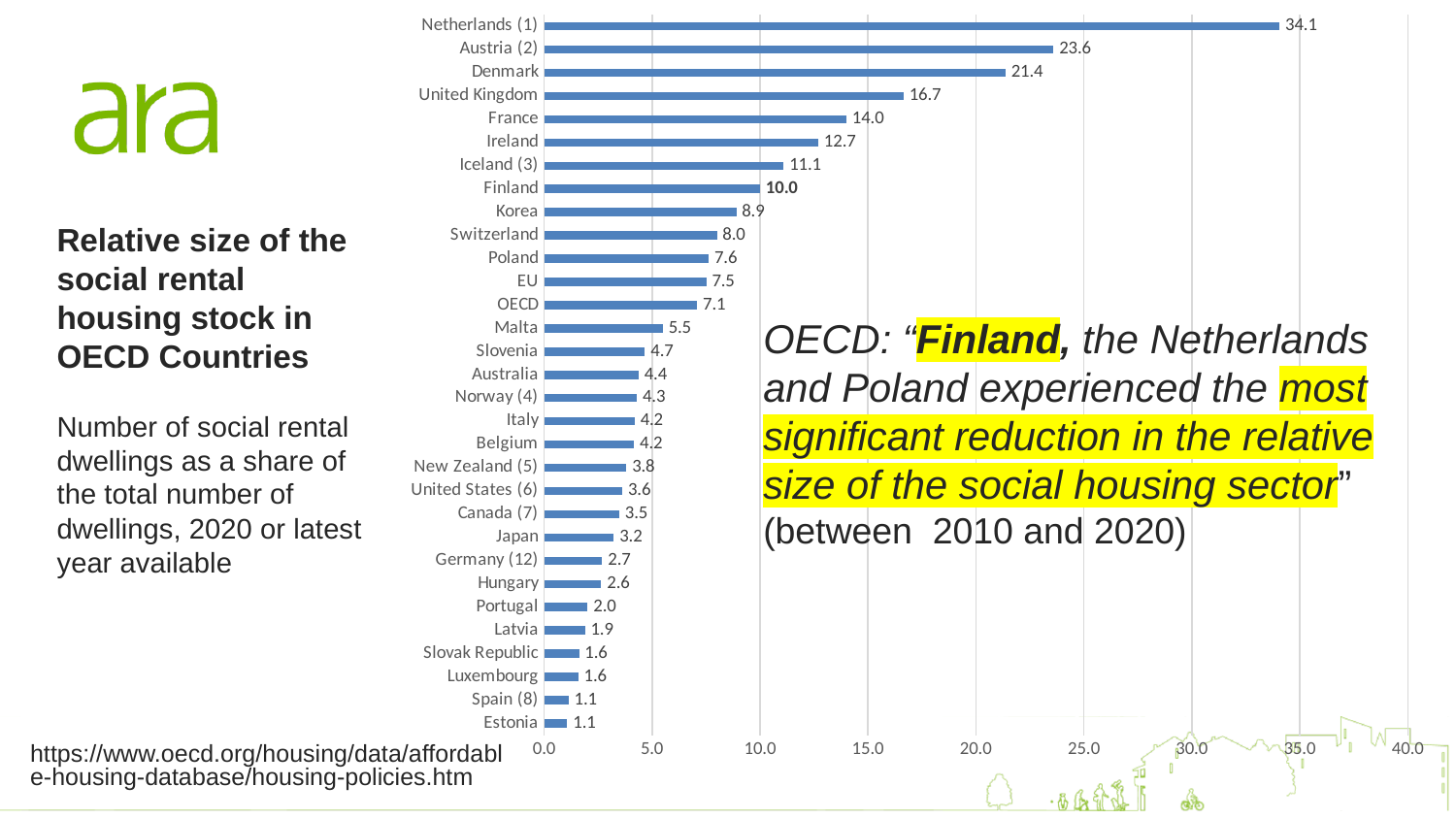
What is the difference between the values for Finland and Korea? 1.1 What is the difference between the values for Austria (2) and Denmark? 2.2 What is the value shown for the Netherlands (1)? 34.1 What is the value shown for the OECD bar? 7.1 What kind of chart is shown on the slide? Bar chart Is the value for the United Kingdom greater or less than 15.0? greater What is the value shown for Poland? 7.6 What is the value shown for Finland? 10.0 What is the highest value marked on the horizontal axis? 40.0 Which country has the highest value in the chart? Netherlands (1) How many categories (bars) are shown in the chart? 31 Which has a larger value, France or Ireland? France